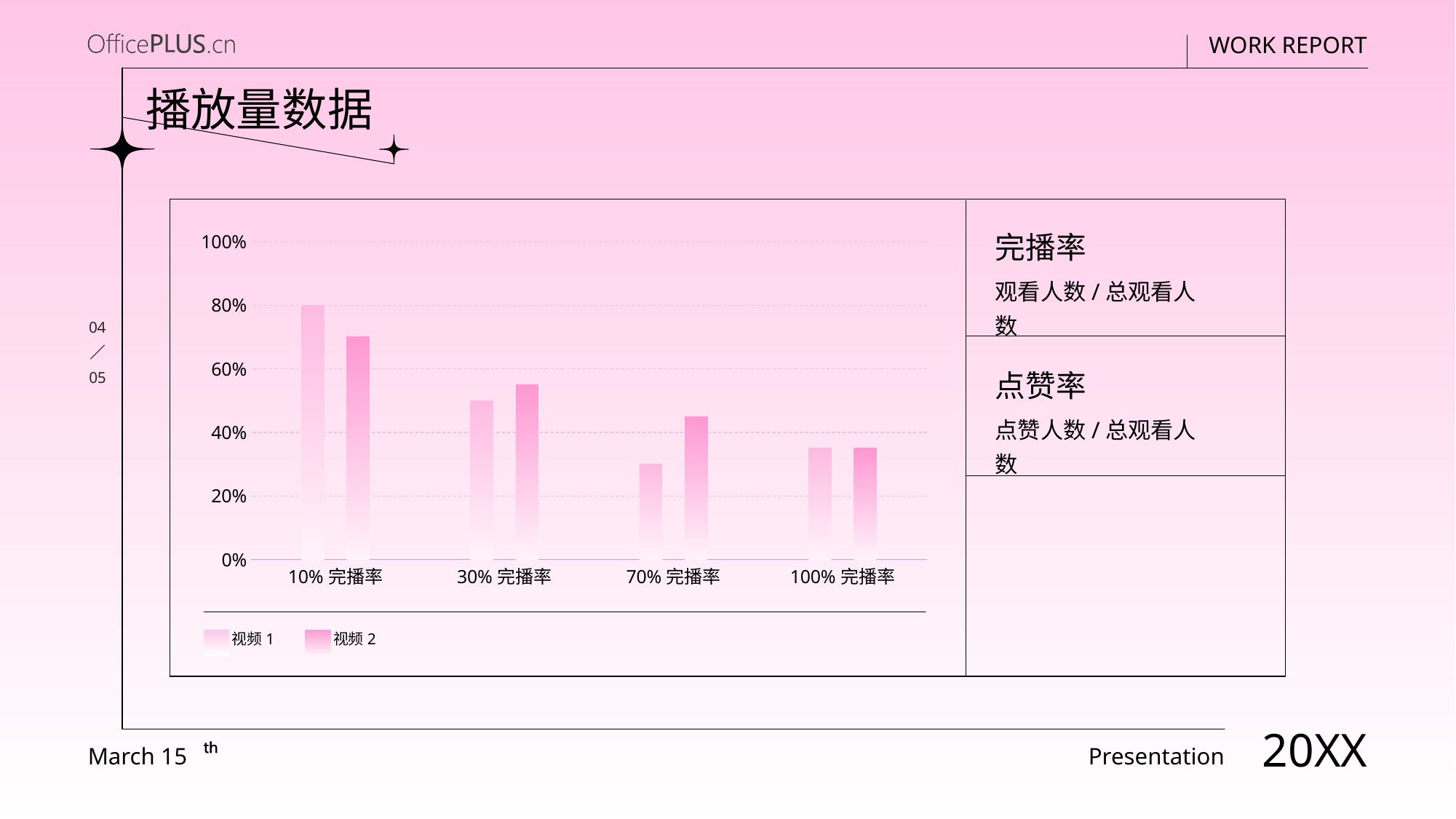
What is the title of the slide containing the chart? 播放量数据 What is the value for 视频 1 at 10% 完播率? 80% For 视频 2, which category has the lowest value? 100% 完播率 What are the two series named in the chart legend? 视频 1 and 视频 2 At 70% 完播率, which series has the larger value, 视频 1 or 视频 2? 视频 2 Do the values for 视频 2 rise or fall from 10% 完播率 to 100% 完播率? fall For 视频 1, which category has the highest value? 10% 完播率 How many categories are shown on the x axis of the chart? 4 Is the value for 视频 2 at 10% 完播率 greater or less than 60%? greater What kind of chart is shown on the slide? bar chart At 10% 完播率, which series has the larger value, 视频 1 or 视频 2? 视频 1 How many series does the chart legend list? 2